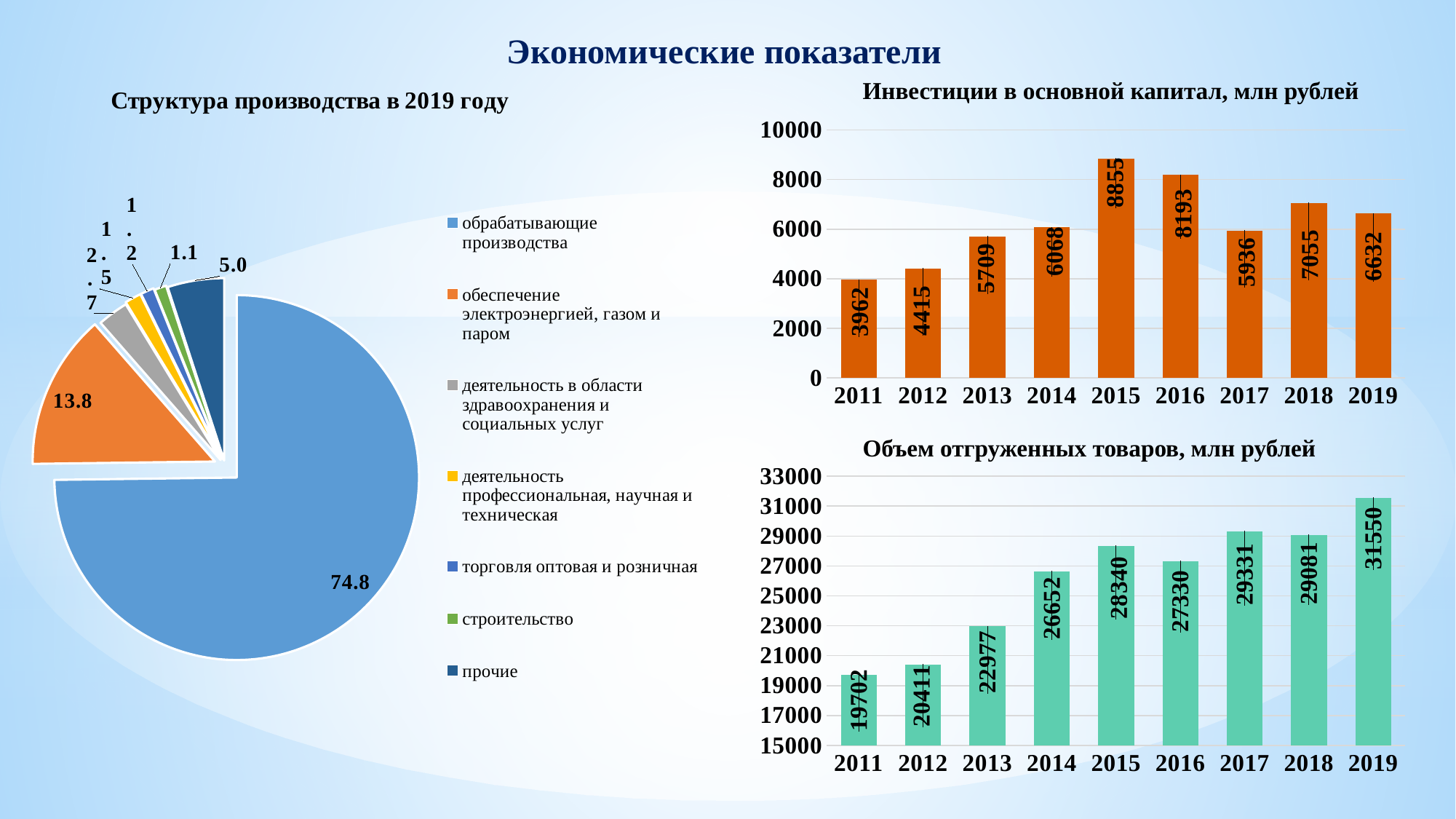
On the chart 'Инвестиции в основной капитал, млн рублей', which is larger, the value for 2016 or the value for 2019? 2016 On the chart 'Инвестиции в основной капитал, млн рублей', what is the difference between the values for 2018 and 2017? 1119 On the chart 'Объем отгруженных товаров, млн рублей', what is the difference between the values for 2014 and 2013? 3675 On the chart 'Объем отгруженных товаров, млн рублей', what is the value for 2019? 31550 On the chart 'Инвестиции в основной капитал, млн рублей', which year has the lowest value? 2011 On the chart 'Объем отгруженных товаров, млн рублей', do the values generally rise or fall from 2011 to 2019? rise On the chart 'Объем отгруженных товаров, млн рублей', how many years are shown on the x axis? 9 On the chart 'Объем отгруженных товаров, млн рублей', which year has the highest value? 2019 On the pie chart 'Структура производства в 2019 году', what is the value for 'обеспечение электроэнергией, газом и паром'? 13.8 On the chart 'Инвестиции в основной капитал, млн рублей', what is the value for 2015? 8855 On the pie chart 'Структура производства в 2019 году', what is the share for 'обрабатывающие производства'? 74.8 What kind of chart is 'Инвестиции в основной капитал, млн рублей'? bar chart